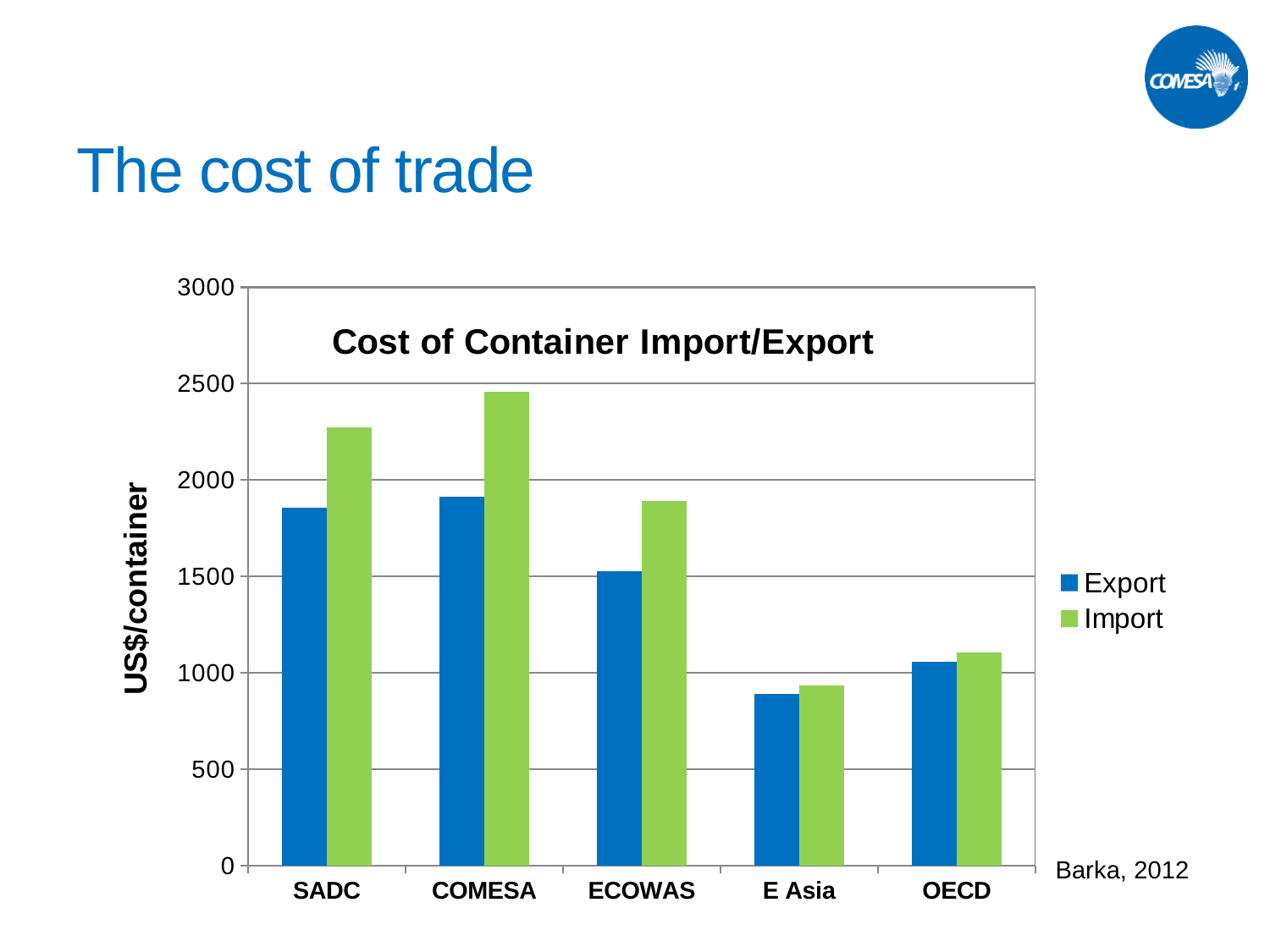
Which category has the lowest Export value? E Asia Which is larger for SADC, the Export value or the Import value? Import Which category has the highest Import value? COMESA How many categories are shown on the x axis? 5 Which category has the lowest Import value? E Asia Is the Import value for SADC greater or less than 2000? greater Is the Export value for E Asia greater or less than 1000? less What kind of chart is shown on the slide? bar chart Which has the larger Export value, COMESA or OECD? COMESA How many series does the legend list? 2 Is the Import value for ECOWAS greater or less than 2000? less What is the title of the chart? Cost of Container Import/Export